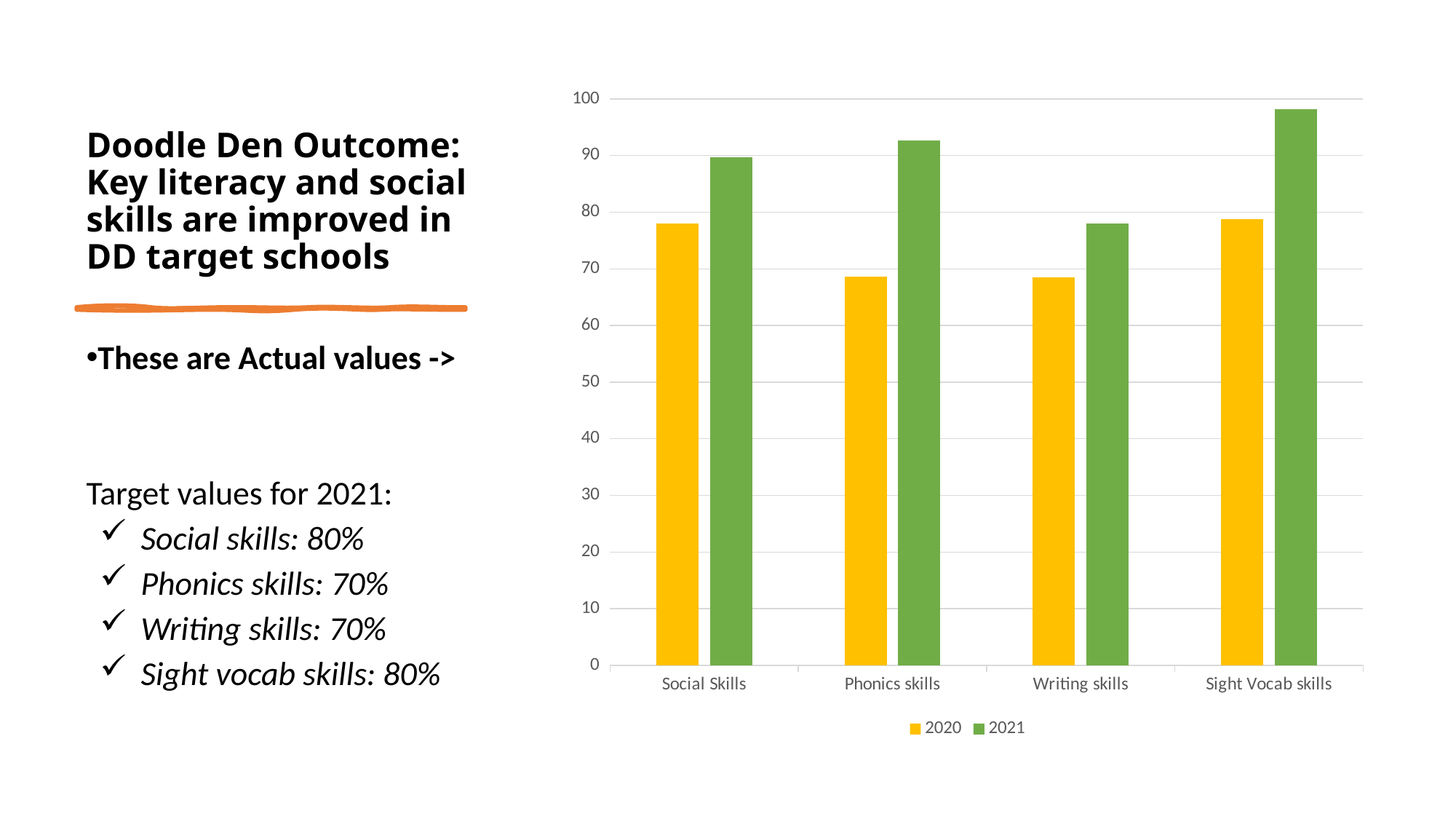
Is the 2021 value for Phonics skills greater or less than 90? greater Which category has the lowest 2021 value? Writing skills Which is larger: the 2021 value for Phonics skills or the 2021 value for Writing skills? Phonics skills Is the 2020 value for Writing skills greater or less than 70? less Is the 2020 value for Social Skills greater or less than 80? less What kind of chart is shown on the slide? bar chart For Social Skills, which is larger: the 2020 value or the 2021 value? 2021 How many series does the chart's legend list? 2 What colour are the bars for the 2021 series? green Which category has the highest 2021 value? Sight Vocab skills How many skill categories are shown on the x axis of the chart? 4